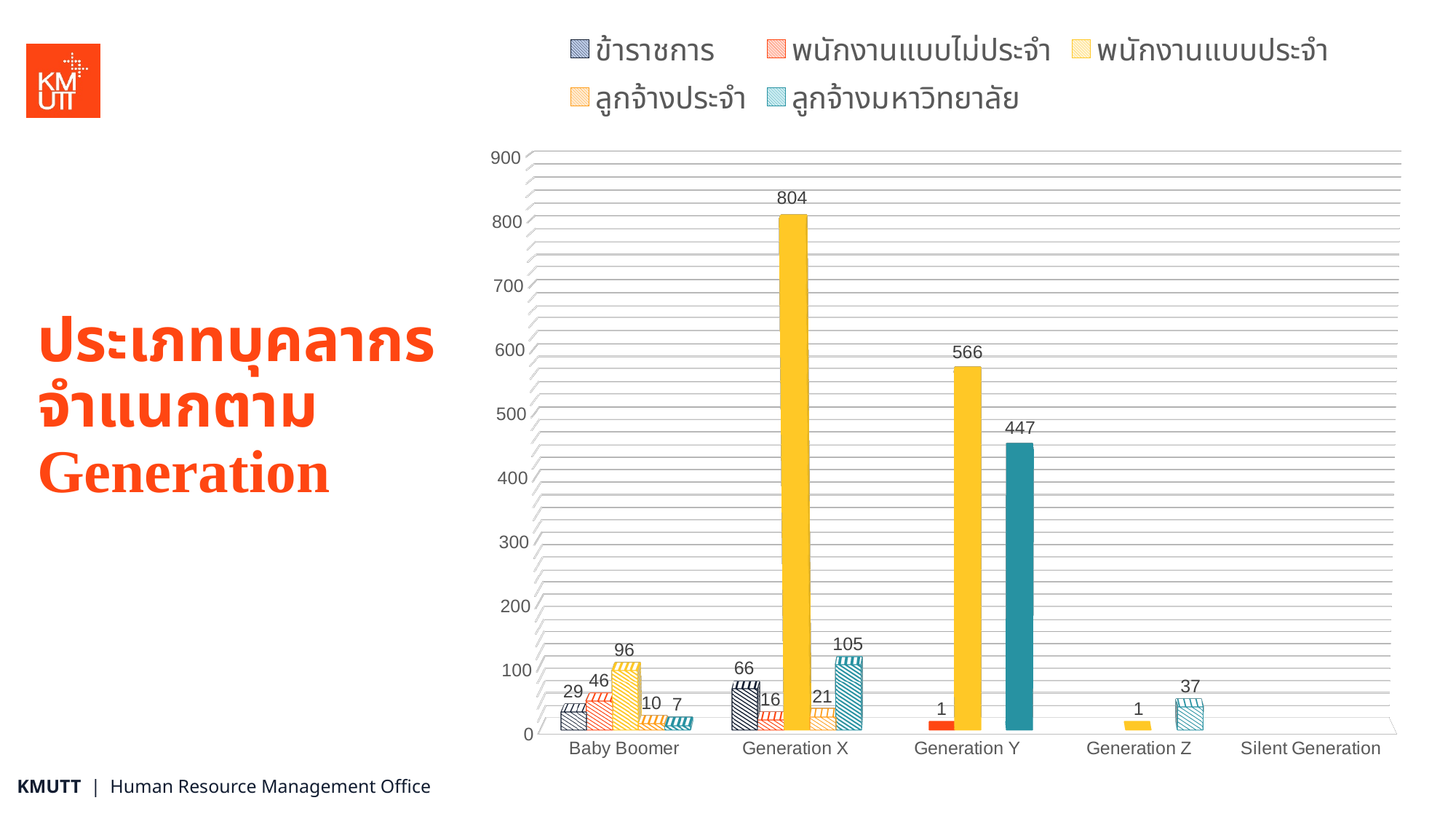
What is the difference between the พนักงานแบบประจำ values for Generation X and Generation Y? 238 What is the difference between the ลูกจ้างมหาวิทยาลัย values for Generation X and Baby Boomer? 98 Which category on the x axis has no bars plotted? Silent Generation What is the value for ลูกจ้างมหาวิทยาลัย in Generation Z? 37 What is the value for ข้าราชการ in Baby Boomer? 29 What is the value for พนักงานแบบประจำ in Generation X? 804 How many generation categories are shown on the x axis? 5 How many series does the legend list? 5 Which generation has the highest value for พนักงานแบบประจำ? Generation X What is the value for ลูกจ้างมหาวิทยาลัย in Generation Y? 447 Which is larger in Generation Y: พนักงานแบบประจำ or ลูกจ้างมหาวิทยาลัย? พนักงานแบบประจำ What type of chart is shown on the slide? bar chart